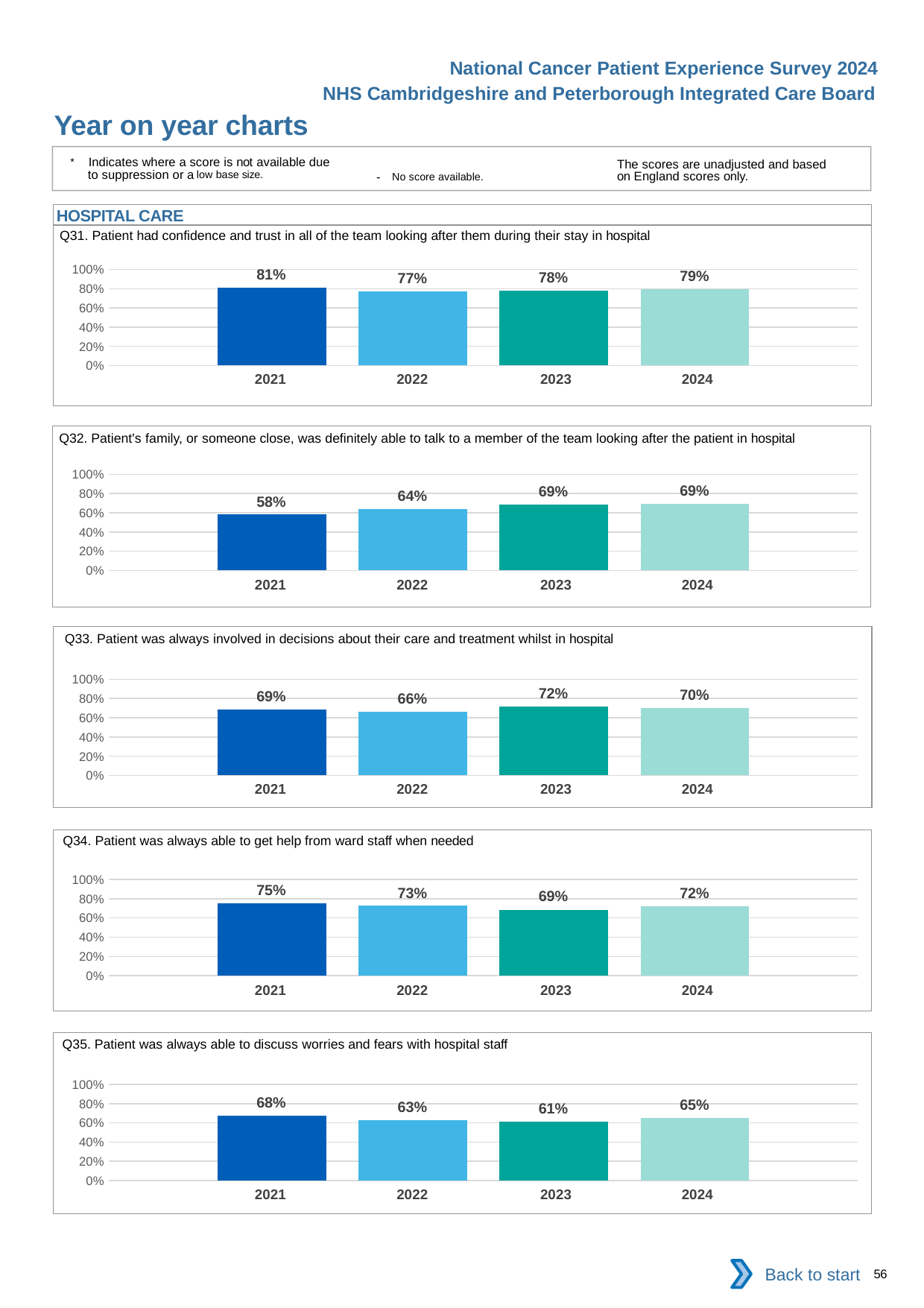
In the Q35 chart, what is the value for 2023? 61% How many years are shown in the Q31 chart? 4 In the Q33 chart, which year has the highest value? 2023 In the Q34 chart, what is the value for 2024? 72% In the Q34 chart, what is the difference between the 2021 and 2023 values? 6% What is the section heading above the Q31 chart? HOSPITAL CARE In the Q35 chart, which is larger, the value for 2021 or the value for 2024? 2021 In the Q32 chart, do the values rise or fall from 2021 to 2023? rise In the Q32 chart, is the value for 2021 greater or less than 60%? less What kind of chart is the Q33 chart? bar chart In the Q32 chart, which year has the lowest value? 2021 In the Q31 chart, what is the value for 2021? 81%